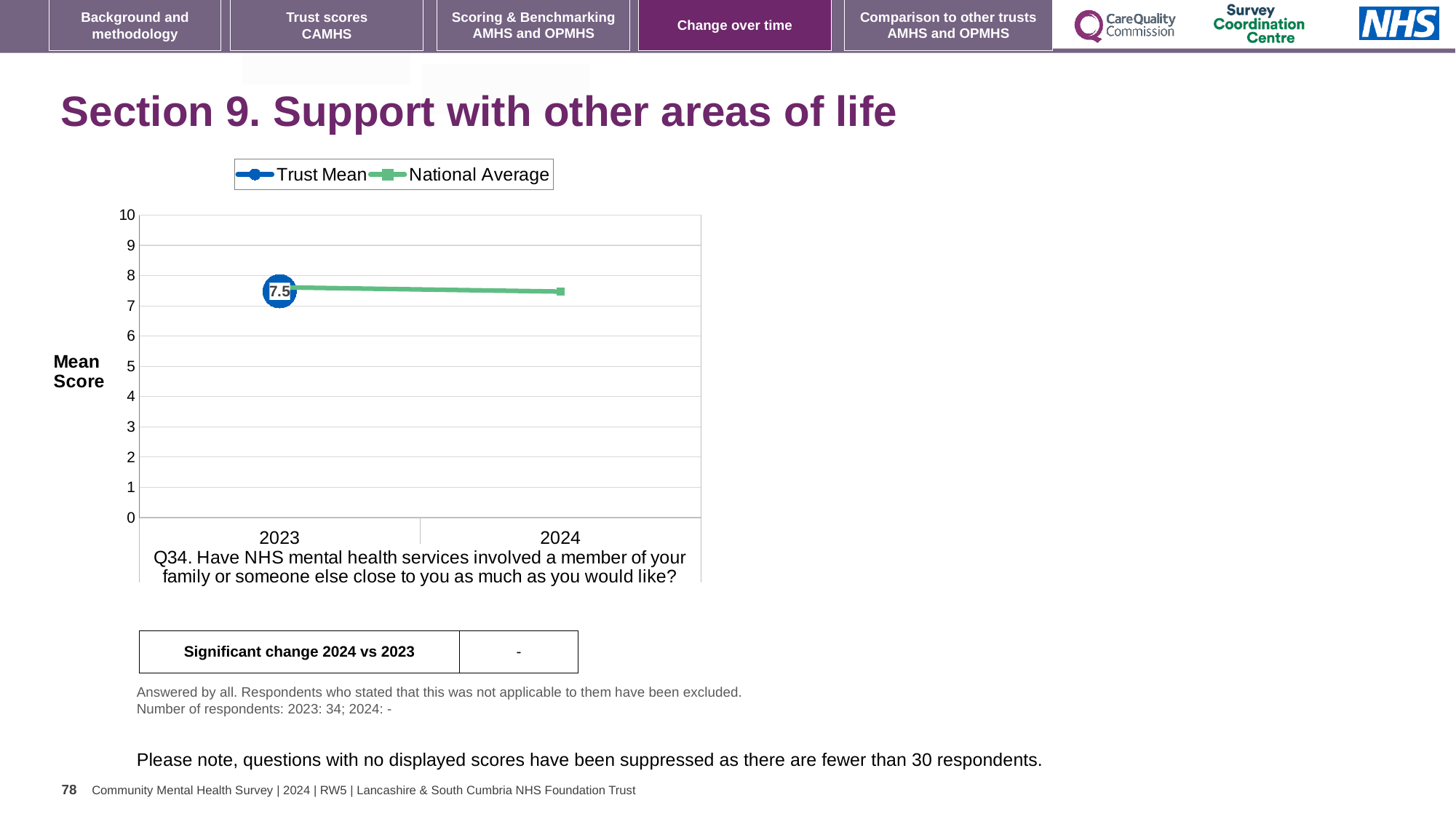
How many series does the legend list? 2 What is the label on the y axis of the chart? Mean Score How many years are shown on the x axis? 2 Is the National Average value for 2023 greater or less than 7? greater Is the Trust Mean value for 2023 greater or less than 8? less What kind of chart is shown on the slide? line chart Does the National Average line rise or fall from 2023 to 2024? fall Is the National Average value for 2024 greater or less than 5? greater What are the two series named in the legend? Trust Mean and National Average What is the Trust Mean score for 2023? 7.5